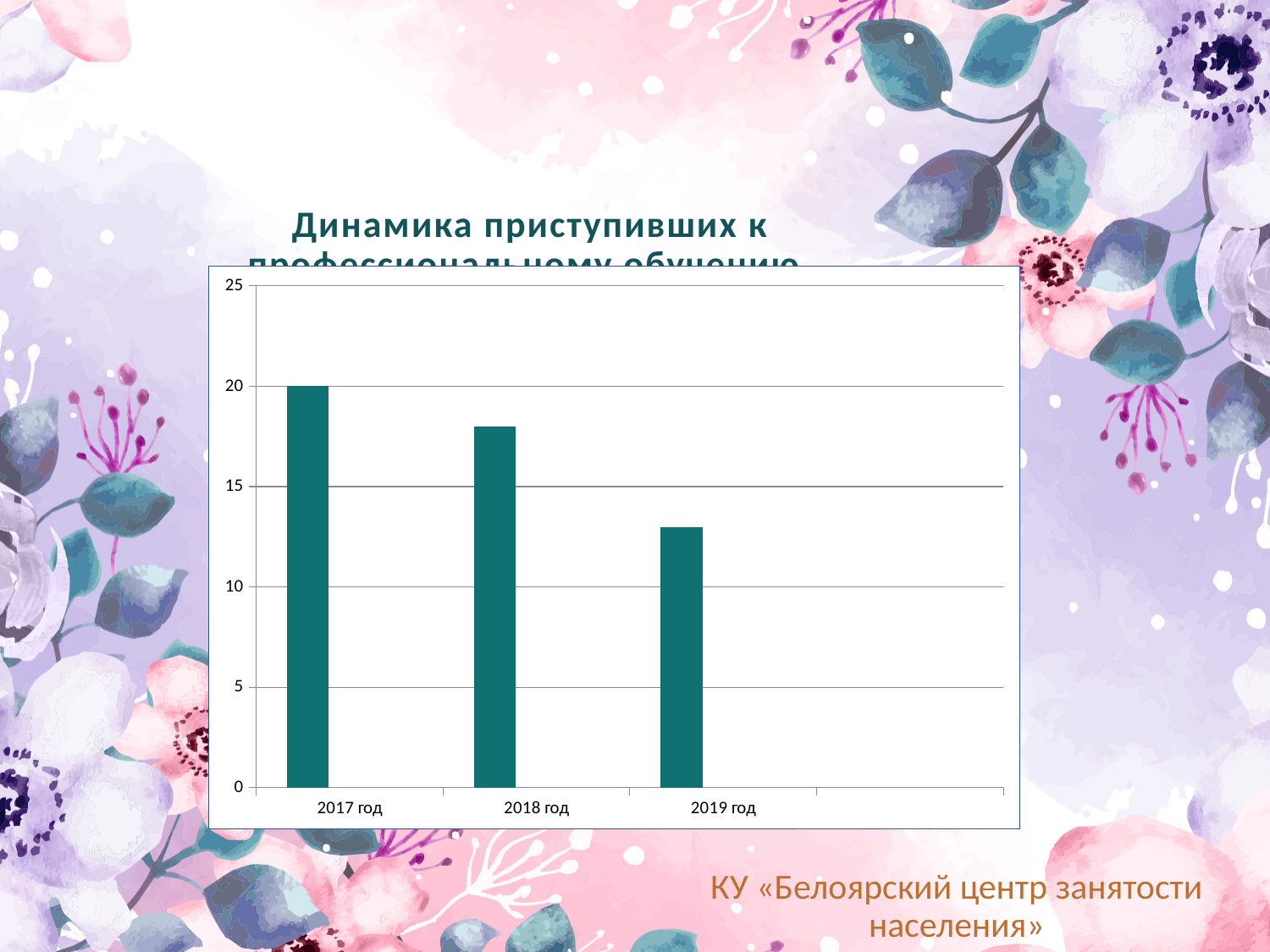
Is the value for 2019 год greater or less than 10? greater What is the value for 2017 год in the chart? 20 Which is larger, the value for 2017 год or the value for 2019 год? 2017 год Which year has the lowest bar in the chart? 2019 год Is the value for 2018 год greater or less than 15? greater Do the values rise or fall from 2017 год to 2019 год? fall Which year has the highest bar in the chart? 2017 год Is the value for 2018 год greater or less than 20? less What is the maximum value shown on the vertical axis of the chart? 25 How many categories (years) are shown on the x axis of the chart? 3 What type of chart is shown on the slide? bar chart